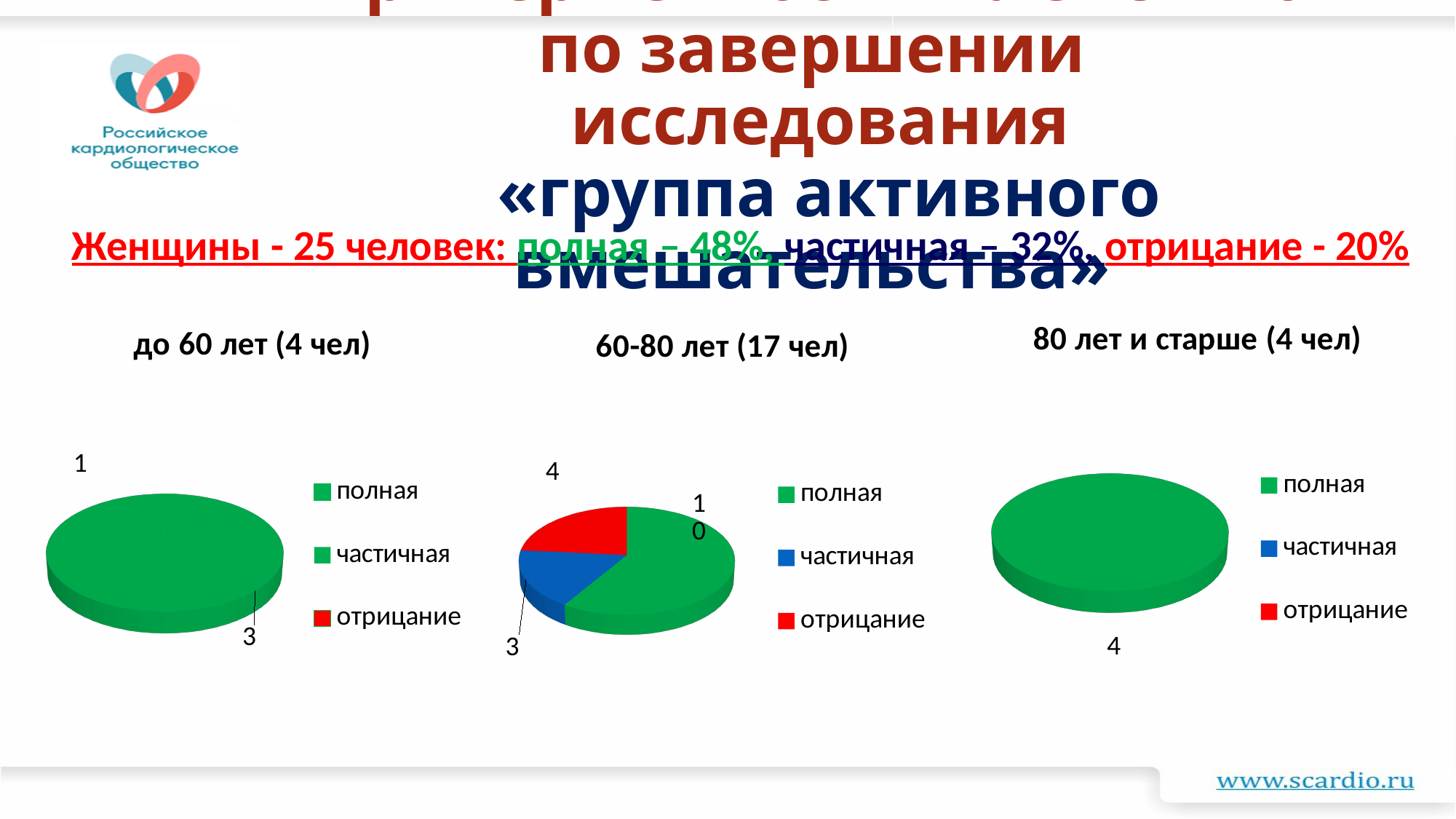
In the chart titled '60-80 лет (17 чел)', which is larger, отрицание or частичная? отрицание In the chart titled '60-80 лет (17 чел)', which category has the largest slice? полная In the chart titled '60-80 лет (17 чел)', what is the difference between полная and отрицание? 6 In the chart titled '60-80 лет (17 чел)', what is the value for полная? 10 In the chart titled '60-80 лет (17 чел)', what is the value for частичная? 3 In the chart titled '60-80 лет (17 чел)', what is the total of all slices? 17 In the chart titled '60-80 лет (17 чел)', which category has the smallest slice? частичная What kind of chart is used on this slide? pie chart How many entries does the legend of the chart titled '60-80 лет (17 чел)' list? 3 How many pie charts are on the slide? 3 In the chart titled '80 лет и старше (4 чел)', what is the value for полная? 4 In the chart titled '60-80 лет (17 чел)', what is the value for отрицание? 4